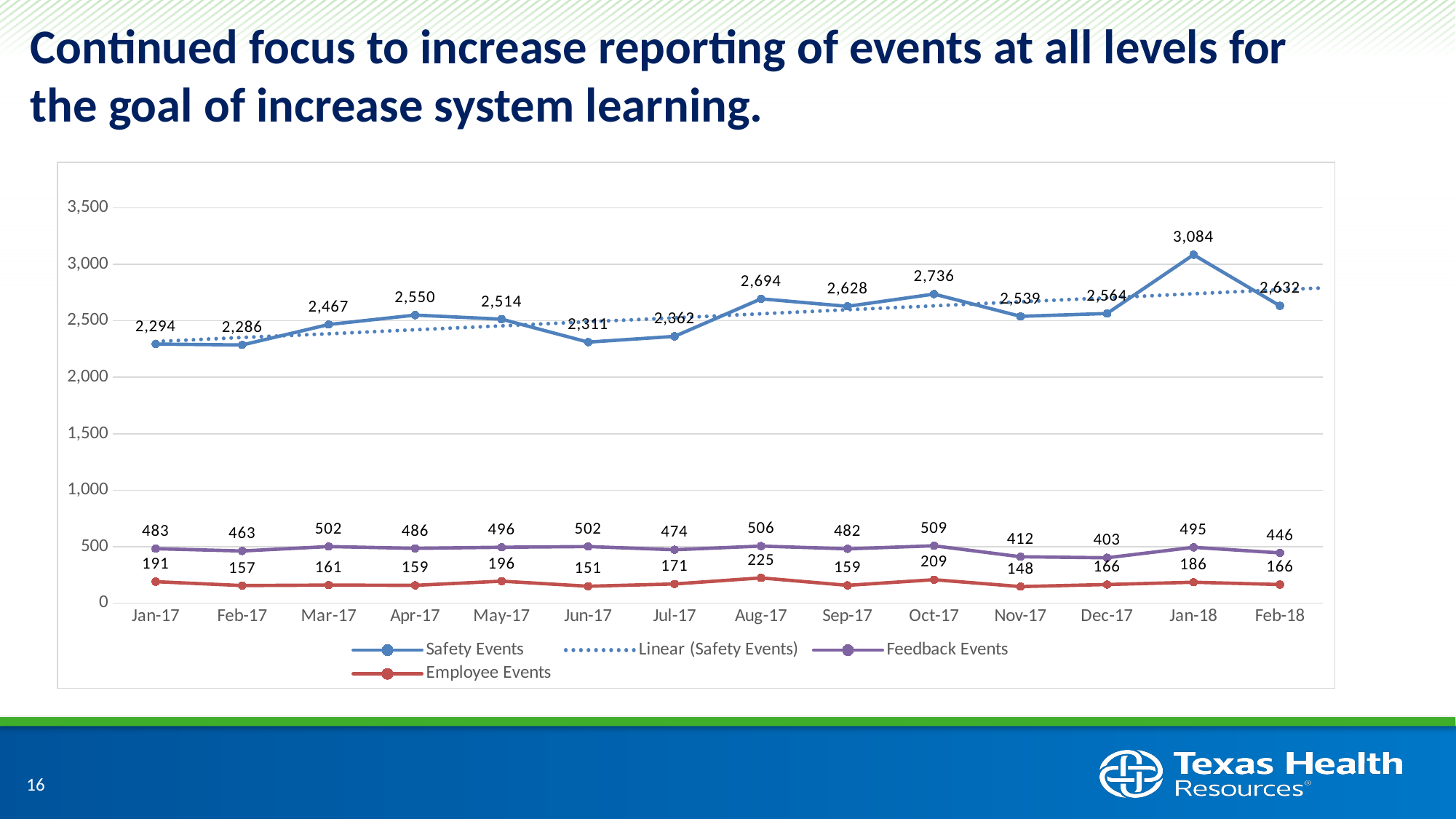
Which month has more Feedback Events, Aug-17 or Nov-17? Aug-17 What kind of chart is shown on the slide? Line chart How many months are shown on the x axis? 14 In which month are Employee Events lowest? Nov-17 What is the difference between Employee Events in Aug-17 and Jun-17? 74 What is the value of Safety Events in Jan-18? 3,084 What is the value of Employee Events in Aug-17? 225 In which month are Safety Events highest? Jan-18 By how much did Safety Events fall from Jan-18 to Feb-18? 452 In which month are Feedback Events lowest? Dec-17 How many entries does the legend list? 4 What is the value of Feedback Events in Oct-17? 509